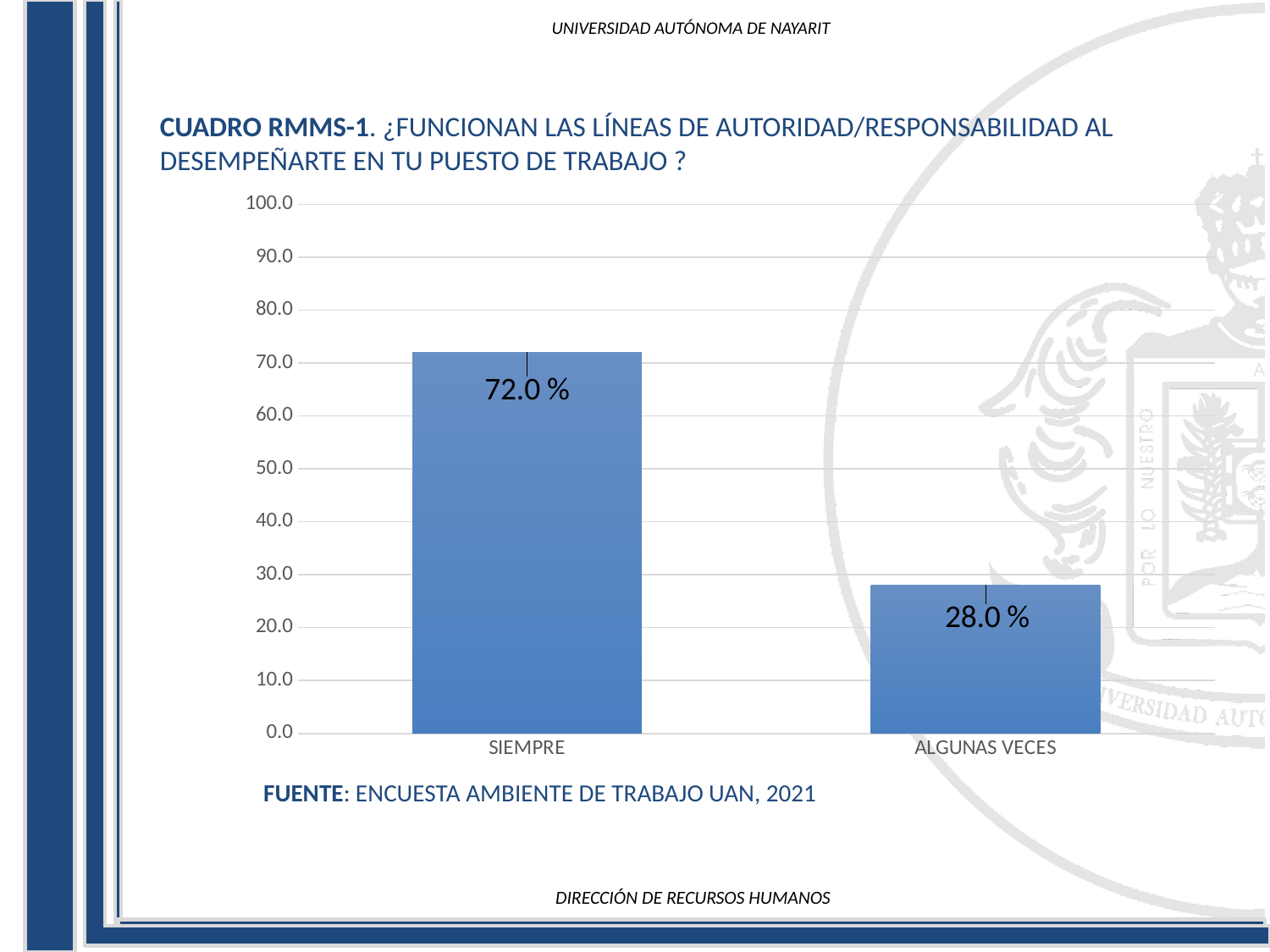
What source is cited below the chart? ENCUESTA AMBIENTE DE TRABAJO UAN, 2021 Which category has the highest value? SIEMPRE Is the value for SIEMPRE greater or less than 70.0? greater What is the total of the two bar values? 100.0 % What is the value for SIEMPRE? 72.0 % What kind of chart is shown on the slide? bar chart What is the difference between the values for SIEMPRE and ALGUNAS VECES? 44.0 % Which category has the lowest value? ALGUNAS VECES How many categories are shown on the x axis? 2 Is the value for ALGUNAS VECES greater or less than 30.0? less Which is larger, the value for SIEMPRE or the value for ALGUNAS VECES? SIEMPRE What is the value for ALGUNAS VECES? 28.0 %